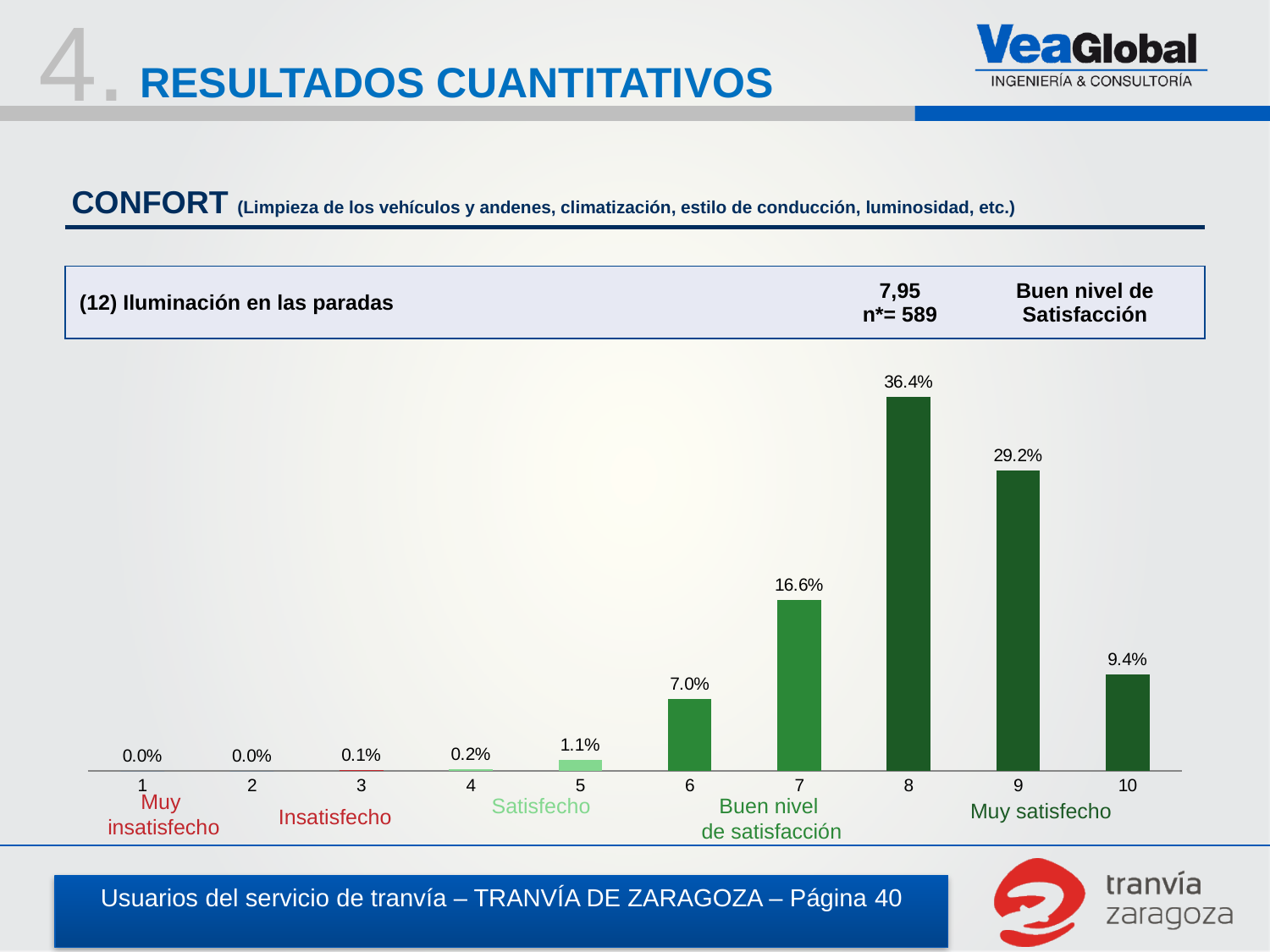
Do the values rise or fall from category 8 to category 10? fall What is the difference between the values for categories 8 and 9? 7.2% Which category has the highest value? 8 What is the value for category 8? 36.4% What is the value for category 10? 9.4% What is the value for category 6? 7.0% How many categories are shown on the x axis? 10 What is the average score shown in the box above the chart for '(12) Iluminación en las paradas'? 7,95 Which is larger, the value for category 9 or the value for category 7? 9 What kind of chart is shown on the slide? bar chart What is the difference between the values for categories 7 and 6? 9.6% What is the value for category 5? 1.1%